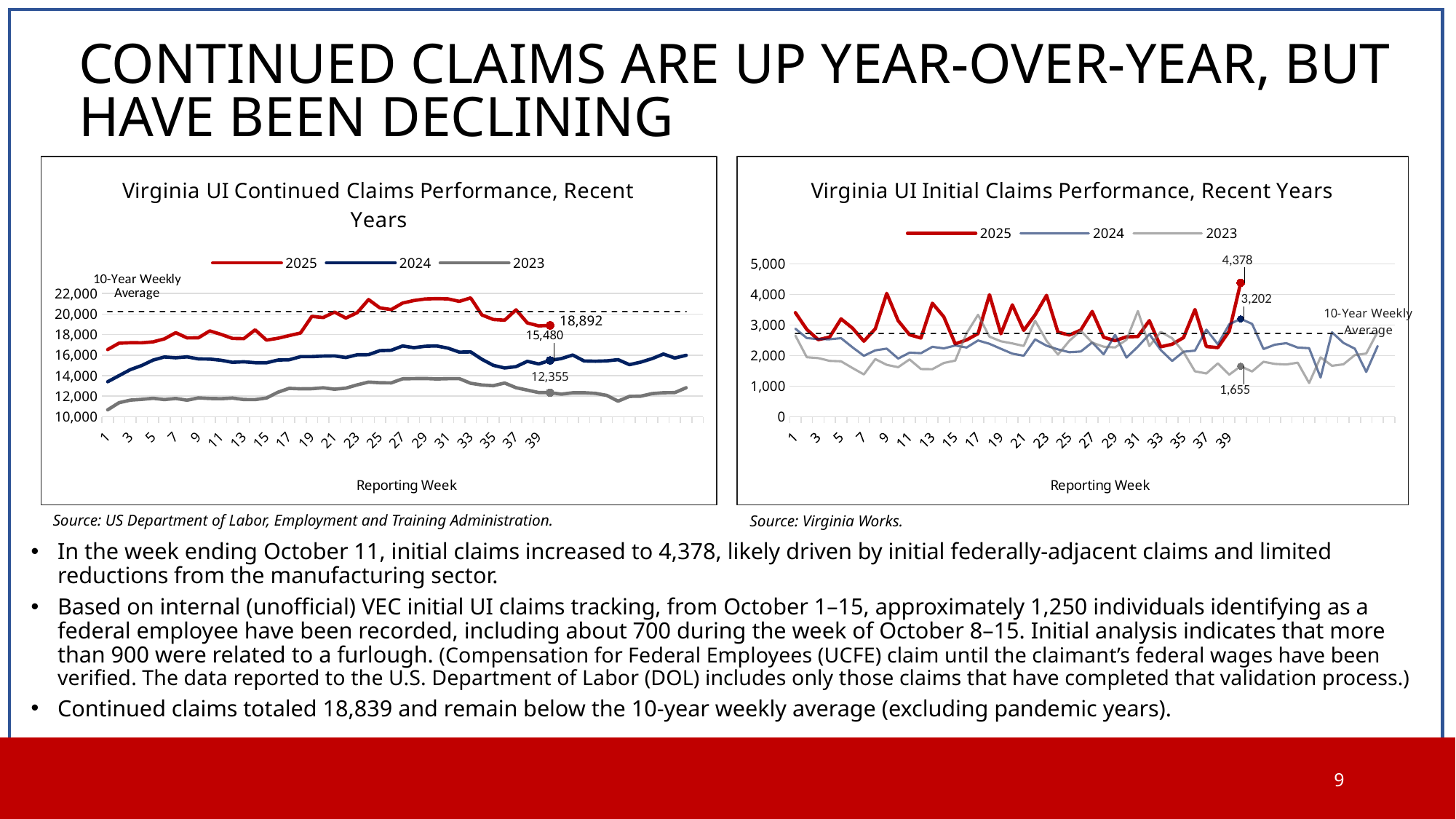
On the Virginia UI Initial Claims Performance chart, what is the labeled value for the 2023 series at its final point? 1,655 On the Virginia UI Continued Claims Performance chart, does the 2025 series rise or fall from week 33 to its final point? fall On the Virginia UI Initial Claims Performance chart, what is the labeled latest value for the 2025 series? 4,378 On the Virginia UI Continued Claims Performance chart, what is the labeled value for the 2023 series at its final point? 12,355 On the Virginia UI Continued Claims Performance chart, what is the labeled latest value for the 2025 series? 18,892 How many series does the legend of the Virginia UI Continued Claims Performance chart list? 3 On the Virginia UI Continued Claims Performance chart, what is the labeled value for the 2024 series at its final point? 15,480 On the Virginia UI Initial Claims Performance chart, which labeled final value is larger: 2024 or 2023? 2024 What kind of chart is the Virginia UI Initial Claims Performance chart? Line chart On the Virginia UI Continued Claims Performance chart, what is the difference between the labeled 2025 value (18,892) and the labeled 2024 value (15,480)? 3,412 On the Virginia UI Continued Claims Performance chart, is the 2023 value at week 1 greater or less than 12,000? less On the Virginia UI Initial Claims Performance chart, what is the difference between the labeled 2025 value (4,378) and the labeled 2024 value (3,202)? 1,176